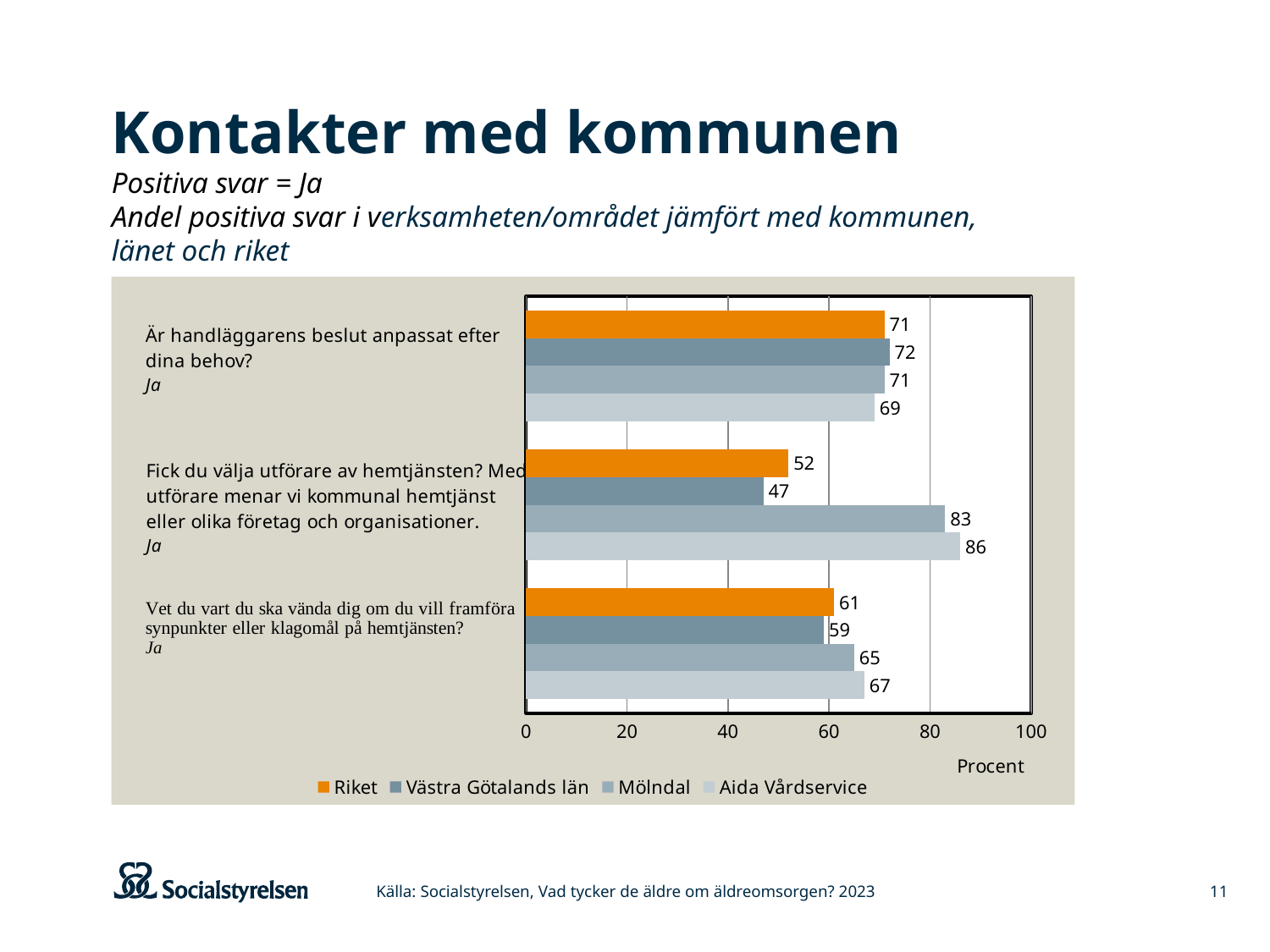
What is the value for Aida Vårdservice for the question 'Fick du välja utförare av hemtjänsten?'? 86 Which series has the highest value for the question 'Vet du vart du ska vända dig om du vill framföra synpunkter eller klagomål på hemtjänsten?'? Aida Vårdservice What is the difference between Mölndal and Riket for the question 'Fick du välja utförare av hemtjänsten?'? 31 How many question categories are plotted on the chart? 3 What is the value for Riket for the question 'Är handläggarens beslut anpassat efter dina behov?'? 71 Is the value for Aida Vårdservice for the question 'Är handläggarens beslut anpassat efter dina behov?' greater or less than 80? less What is the label of the x axis? Procent Which series has the lowest value for the question 'Fick du välja utförare av hemtjänsten?'? Västra Götalands län What kind of chart is shown on the slide? Bar chart How many series does the legend list? 4 What is the value for Västra Götalands län for the question 'Vet du vart du ska vända dig om du vill framföra synpunkter eller klagomål på hemtjänsten?'? 59 For the question 'Vet du vart du ska vända dig om du vill framföra synpunkter eller klagomål på hemtjänsten?', which is larger: Mölndal or Riket? Mölndal